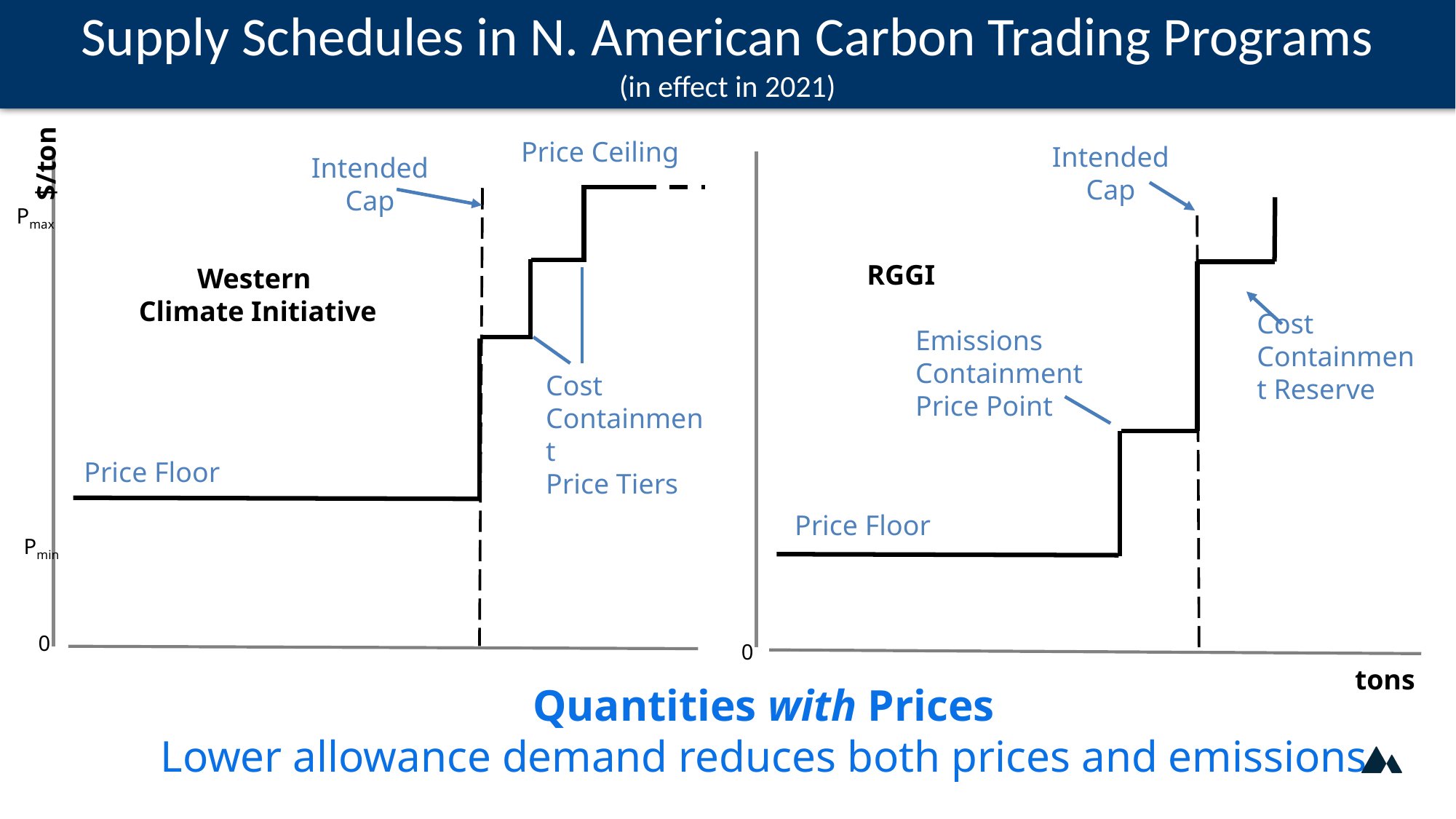
In the Western Climate Initiative chart, does the price rise or fall as quantity (tons) increases along the x axis? rises In the RGGI chart, is the Cost Containment Reserve level higher or lower than the Emissions Containment Price Point? higher How many distinct horizontal price levels does the RGGI supply schedule show? 3 Which of the two charts shows a Price Ceiling? Western Climate Initiative In the Western Climate Initiative chart, is the Price Ceiling higher or lower than the Price Floor? higher How many Cost Containment Price Tier steps are shown between the Price Floor and the Price Ceiling in the Western Climate Initiative chart? 2 What is the label on the horizontal axis of the charts? tons What kind of chart is the Western Climate Initiative diagram? line chart In the RGGI chart, does the price rise or fall as quantity increases along the x axis? rises What is the label on the vertical axis of the charts? $/ton